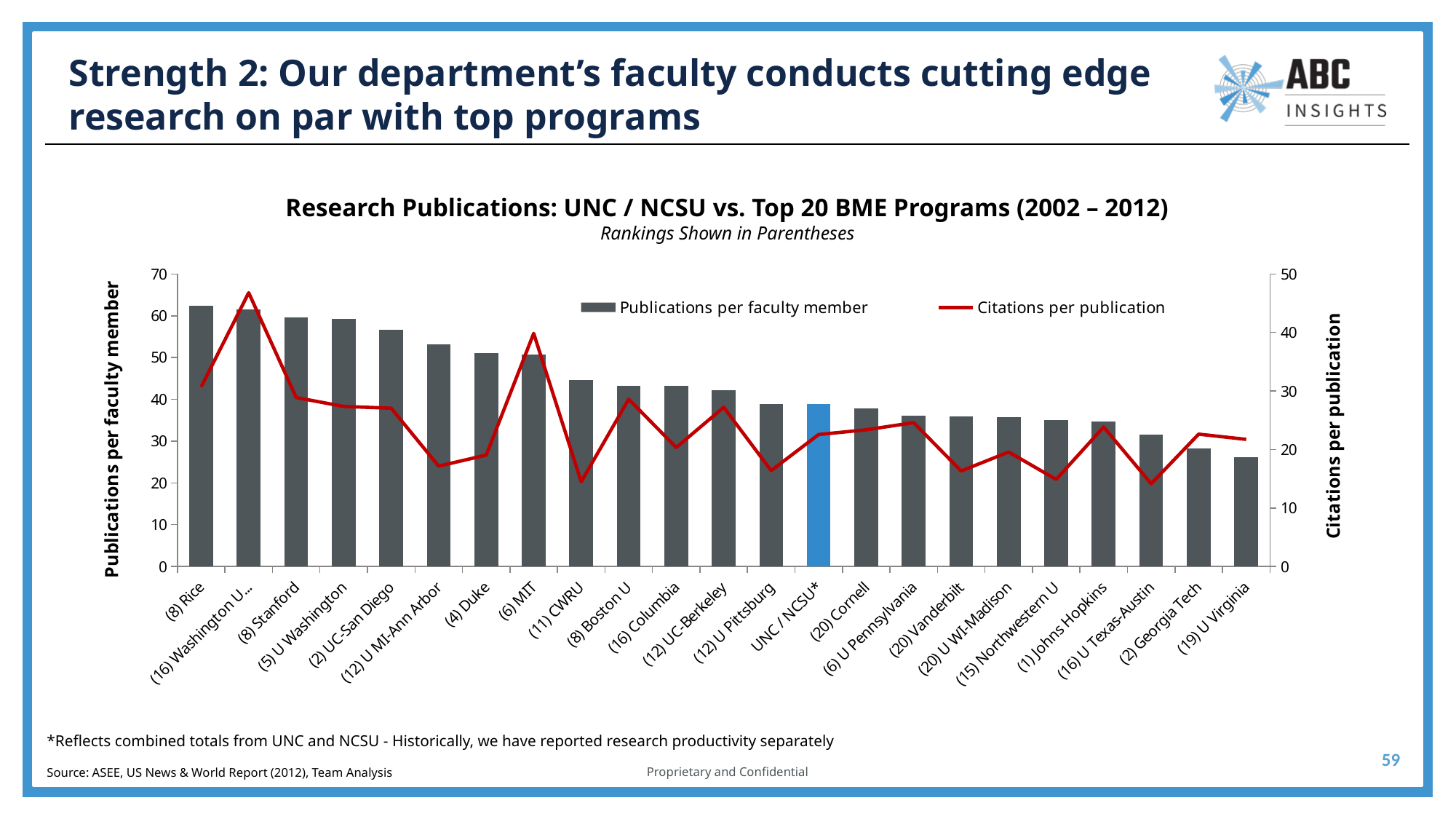
Is the publications per faculty member value for (8) Rice greater or less than 60? greater Which has more publications per faculty member, (8) Stanford or (20) Cornell? (8) Stanford Which program has the lowest publications per faculty member? (19) U Virginia Which program has the highest citations per publication? (16) Washington U Is the publications per faculty member value for (1) Johns Hopkins greater or less than 40? less What kind of chart is used to show publications per faculty member? bar chart Which bar is highlighted in blue rather than grey? UNC / NCSU* Is the citations per publication value for (11) CWRU greater or less than 20? less How many programs are shown along the x axis? 23 How many series does the legend list? 2 Do the publications per faculty member bars rise or fall from left to right across the x axis? fall